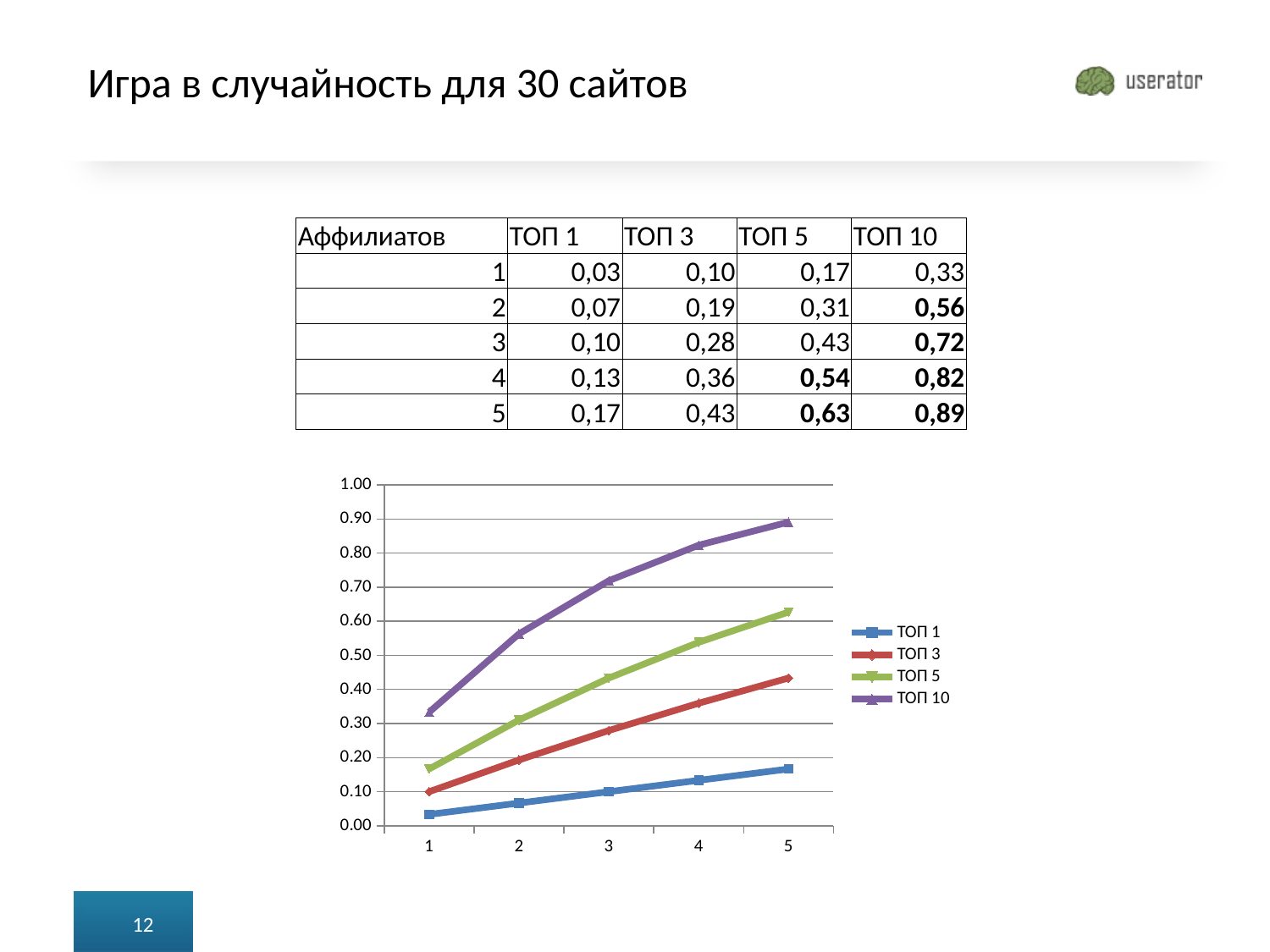
How many series does the chart legend list? 4 Which is larger: ТОП 3 at 4 affiliates or ТОП 5 at 1 affiliate? ТОП 3 at 4 affiliates According to the table, what is the value for ТОП 1 at 1 affiliate? 0,03 According to the table, what is the value for ТОП 10 at 5 affiliates? 0,89 Which series has the highest value at x = 5? ТОП 10 Is the value for ТОП 3 at x = 1 greater or less than 0.20? less Which series has the lowest values across the chart? ТОП 1 Does the ТОП 10 line rise or fall as the number of affiliates increases from 1 to 5? rises Is the value for ТОП 5 at x = 5 greater or less than 0.50? greater What kind of chart is shown on the slide? line chart How many points are plotted along the x axis for each series? 5 Using the table values, what is the difference between ТОП 10 and ТОП 1 at 5 affiliates? 0,72